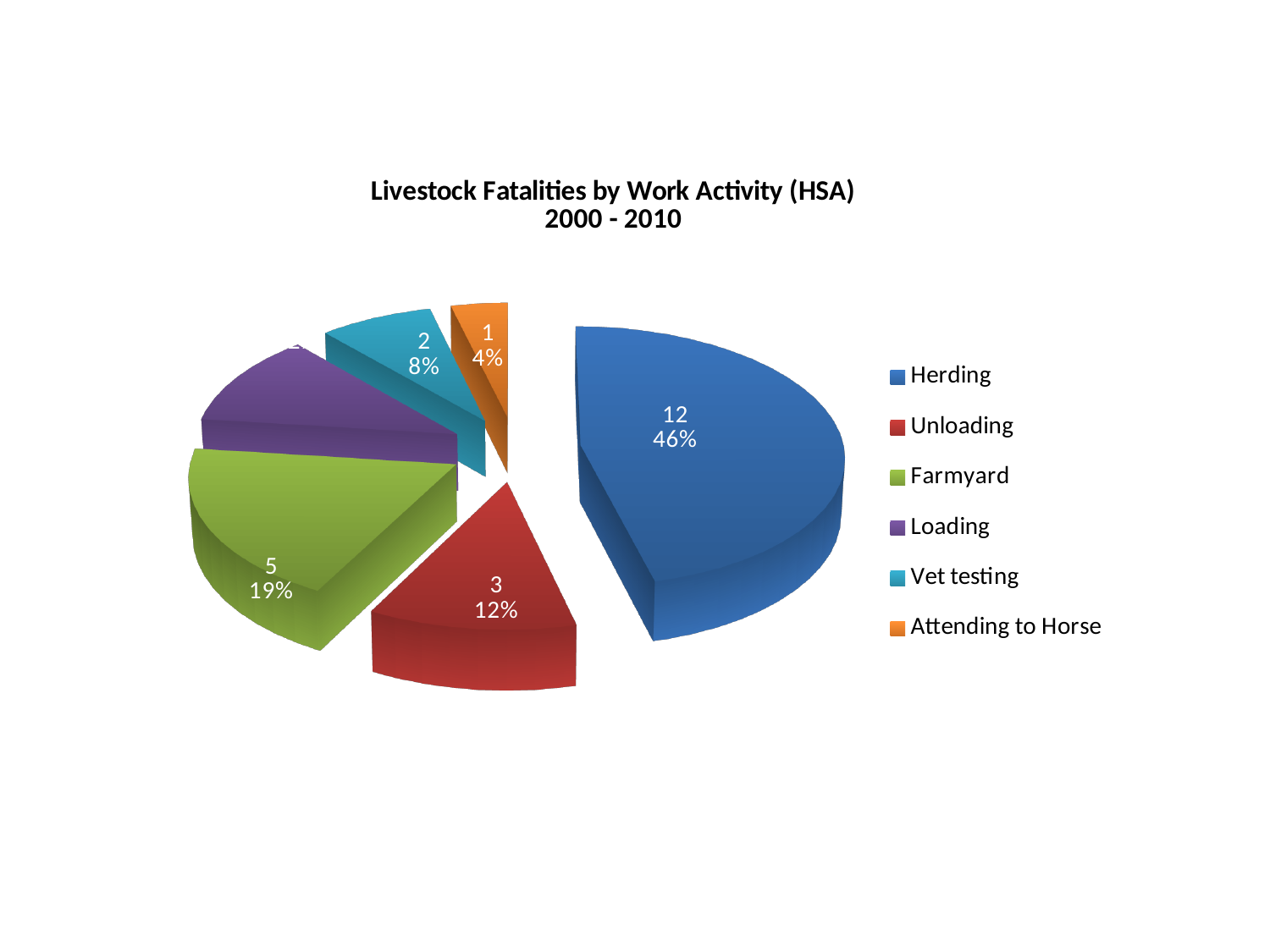
What percentage share of the pie does Herding represent? 46% Which work activity has the lowest number of fatalities? Attending to Horse What is the title of the chart? Livestock Fatalities by Work Activity (HSA) 2000 - 2010 What is the difference between the number of fatalities for Herding and for Unloading? 9 How many categories does the legend list? 6 How many fatalities are shown for Farmyard? 5 What percentage share of the pie does Attending to Horse represent? 4% Which work activity has the highest number of fatalities? Herding What percentage share of the pie does Unloading represent? 12% What type of chart is shown on the slide? Pie chart How many fatalities are shown for Herding? 12 How many fatalities are shown for Vet testing? 2